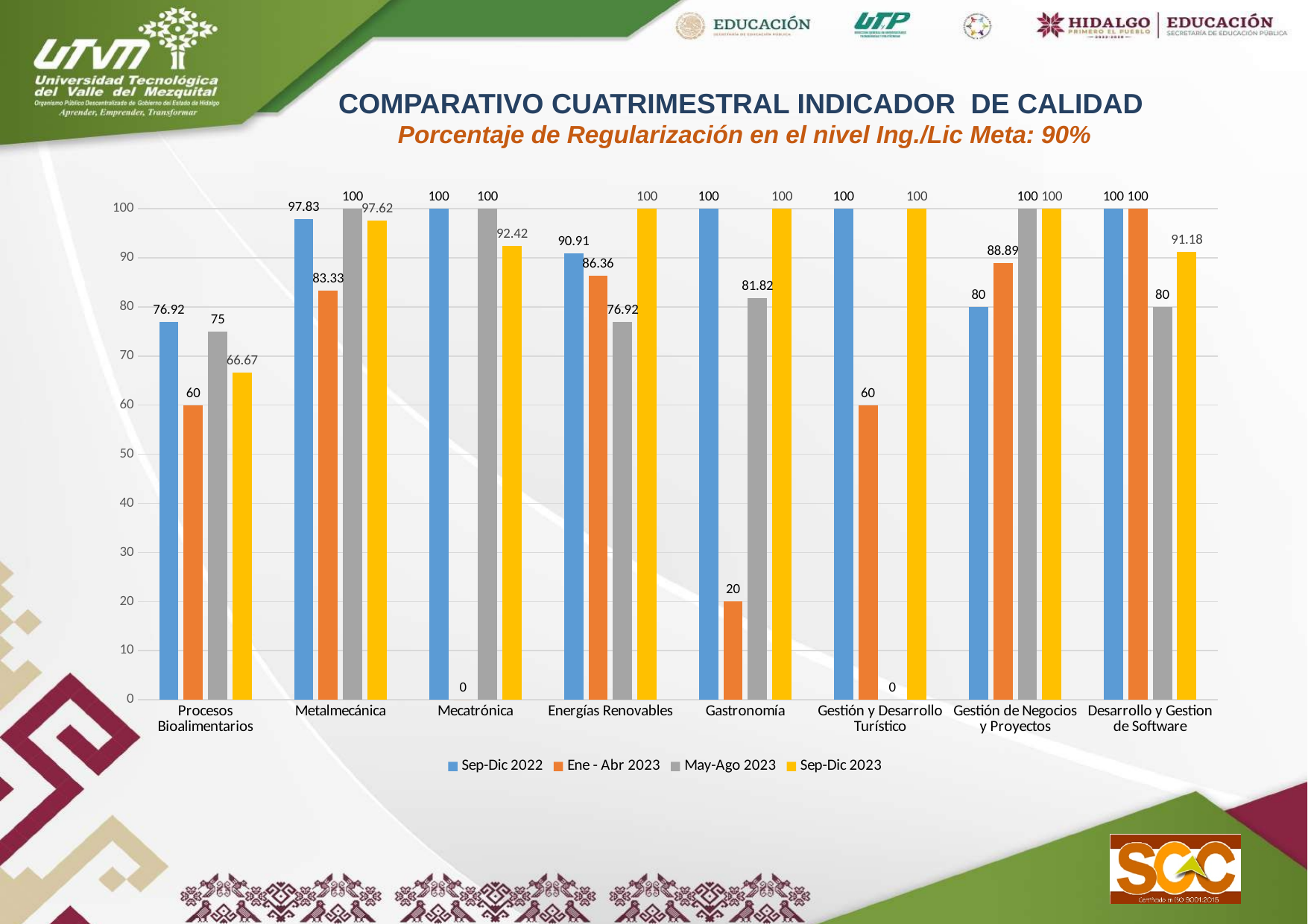
Which category has the lowest Ene - Abr 2023 value? Mecatrónica What is the difference between the Sep-Dic 2022 and Ene - Abr 2023 values for Metalmecánica? 14.5 What target (Meta) is stated in the chart subtitle? 90% What is the Ene - Abr 2023 value for Gastronomía? 20 What is the May-Ago 2023 value for Energías Renovables? 76.92 Which is larger for Gestión de Negocios y Proyectos: the Sep-Dic 2022 value or the Ene - Abr 2023 value? Ene - Abr 2023 What is the Sep-Dic 2023 value for Desarrollo y Gestion de Software? 91.18 How many series does the legend list? 4 What type of chart is shown on the slide? bar chart What is the Sep-Dic 2023 value for Procesos Bioalimentarios? 66.67 Which category has the lowest Sep-Dic 2022 value? Procesos Bioalimentarios How many program categories are shown on the x axis? 8